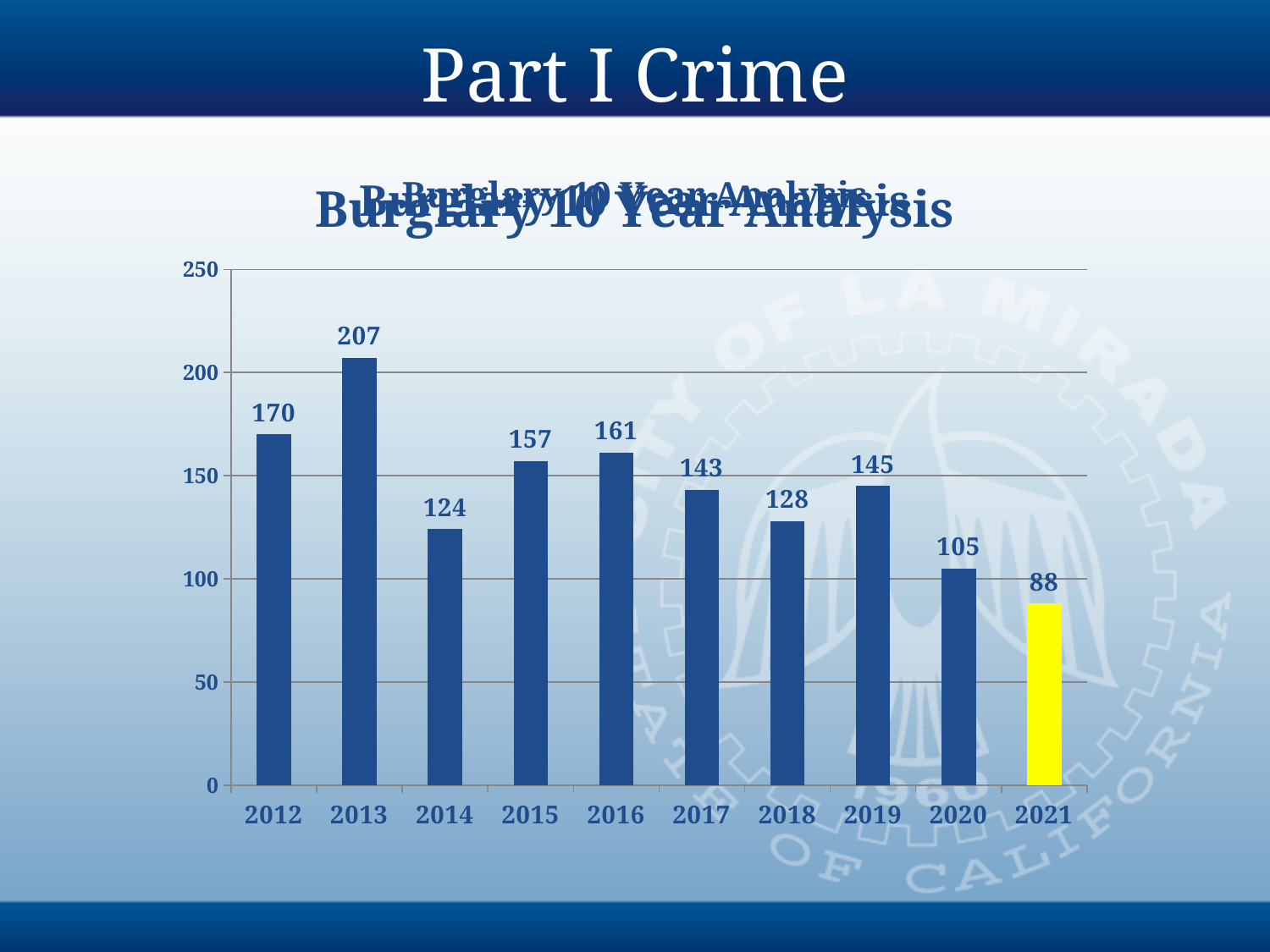
Which bar on the chart is coloured yellow? 2021 Which year has the lowest burglary value? 2021 What is the difference between the burglary values for 2020 and 2021? 17 What kind of chart is shown on the slide? Bar chart What is the burglary value for 2017? 143 Is the burglary value for 2019 greater or less than 100? greater Which year has the highest burglary value? 2013 Which year has a larger burglary value, 2015 or 2016? 2016 How many years are shown on the chart? 10 What is the burglary value for 2013? 207 What is the burglary value for 2021? 88 What is the difference between the burglary values for 2013 and 2014? 83